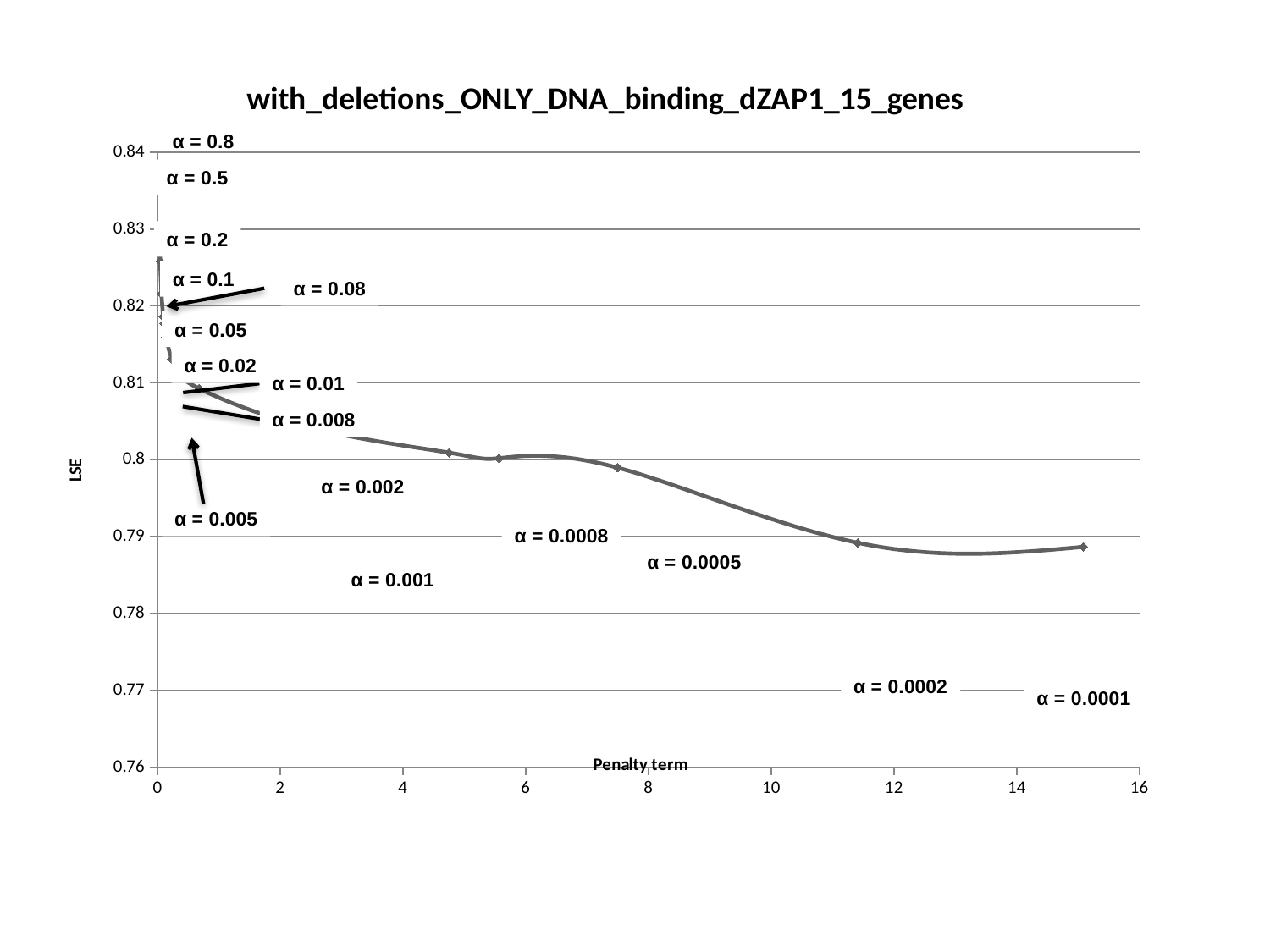
Is the LSE value for the point labelled α = 0.002 greater or less than 0.79? greater Is the LSE value for the point labelled α = 0.8 greater or less than 0.81? greater What is the label of the x axis? Penalty term What kind of chart is shown on the slide? line chart What is the title of the chart? with_deletions_ONLY_DNA_binding_dZAP1_15_genes Is the LSE value for the point labelled α = 0.0002 greater or less than 0.8? less Which has the higher LSE value, the point labelled α = 0.002 or the point labelled α = 0.0001? α = 0.002 Overall, do the LSE values rise or fall as the penalty term increases? fall Which annotated point has the lowest LSE value, α = 0.8 or α = 0.0002? α = 0.0002 How many α values are annotated on the chart? 16